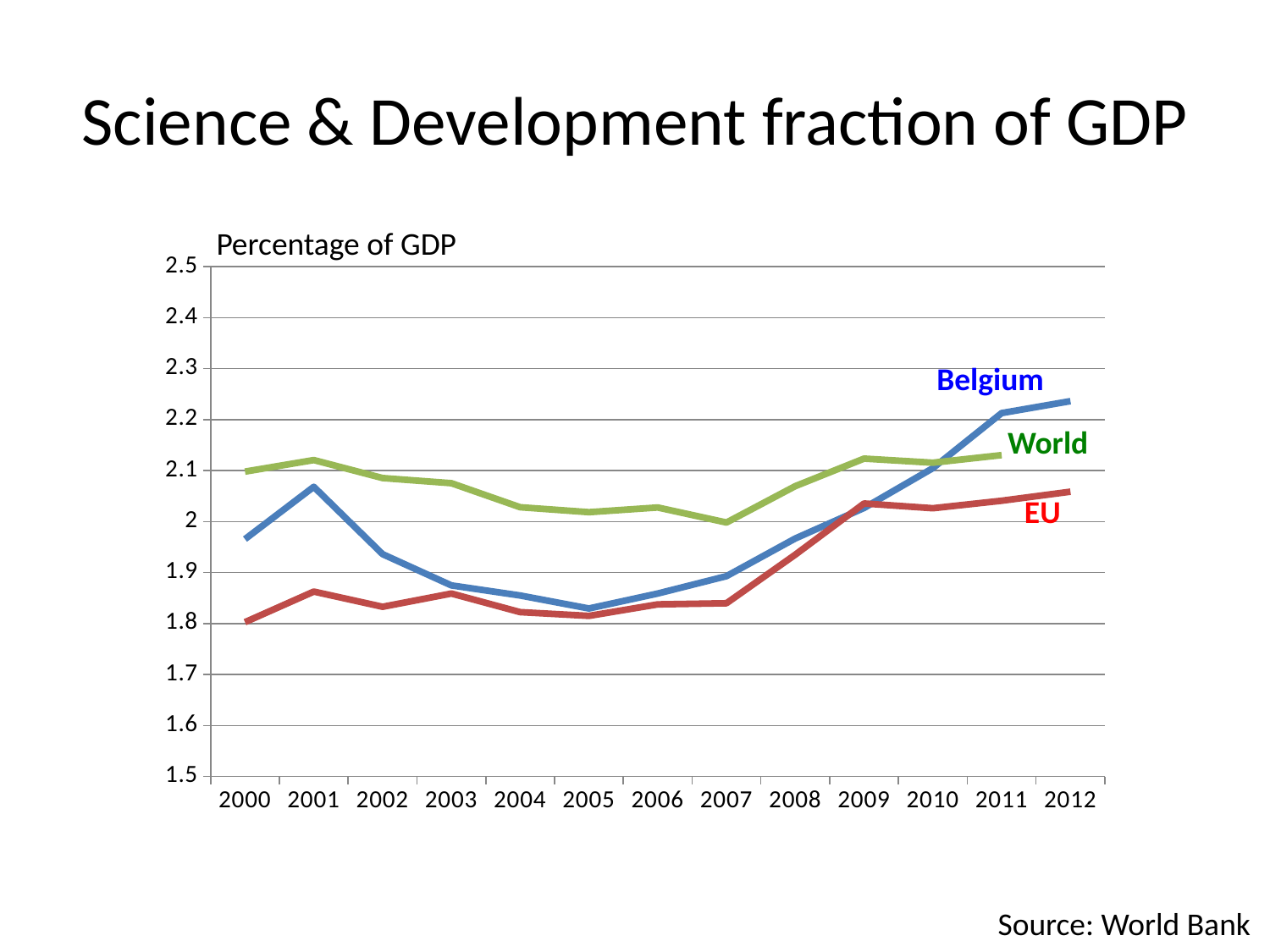
Is the value for World in 2000 greater or less than 2? greater What kind of chart is shown on the slide? Line chart How many series are plotted on the chart? 3 What is the label on the vertical axis of the chart? Percentage of GDP Is the value for Belgium in 2005 greater or less than 1.9? less How many years are shown along the x axis? 13 Is the value for Belgium in 2012 greater or less than 2.2? greater In 2005, which is higher: World or Belgium? World Which series has the highest value in 2012? Belgium Does the Belgium line rise or fall between 2007 and 2012? Rises Which series has the lowest value in 2000? EU